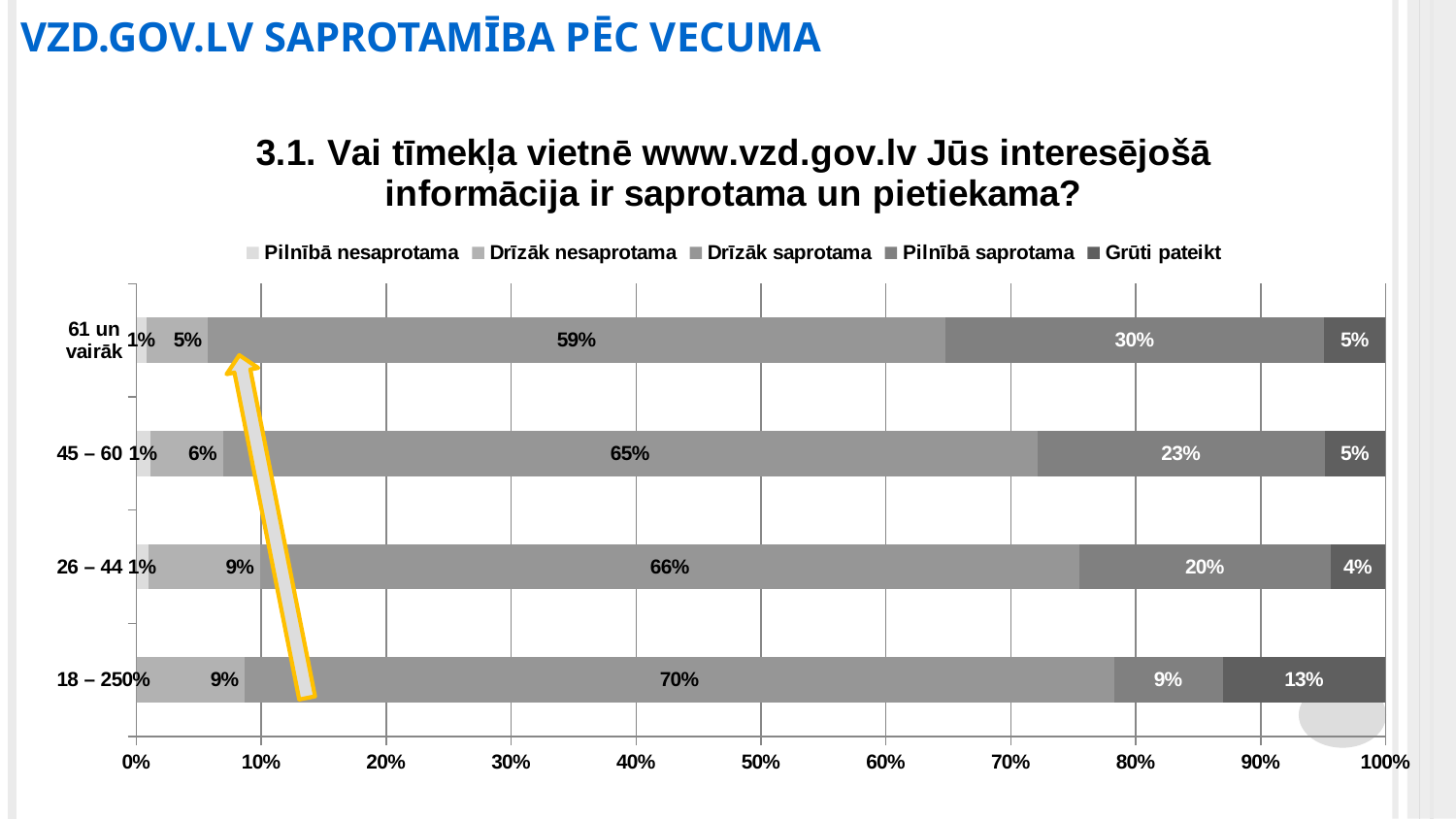
How many series does the legend list? 5 What is the value for "Pilnībā saprotama" in the "61 un vairāk" age group? 30% What is the difference between the "Pilnībā saprotama" values for "61 un vairāk" and "26 – 44"? 10% How many age groups are shown on the chart? 4 Which age group has the lowest value for "Pilnībā saprotama"? 18 – 25 Which is larger: the "Grūti pateikt" value for "18 – 25" or for "26 – 44"? 18 – 25 What is the value for "Drīzāk saprotama" in the "18 – 25" age group? 70% What is the value for "Grūti pateikt" in the "18 – 25" age group? 13% Which age group has the highest value for "Drīzāk saprotama"? 18 – 25 What is the value for "Drīzāk nesaprotama" in the "45 – 60" age group? 6% What type of chart is shown on the slide? stacked bar chart What is the first series listed in the legend? Pilnībā nesaprotama